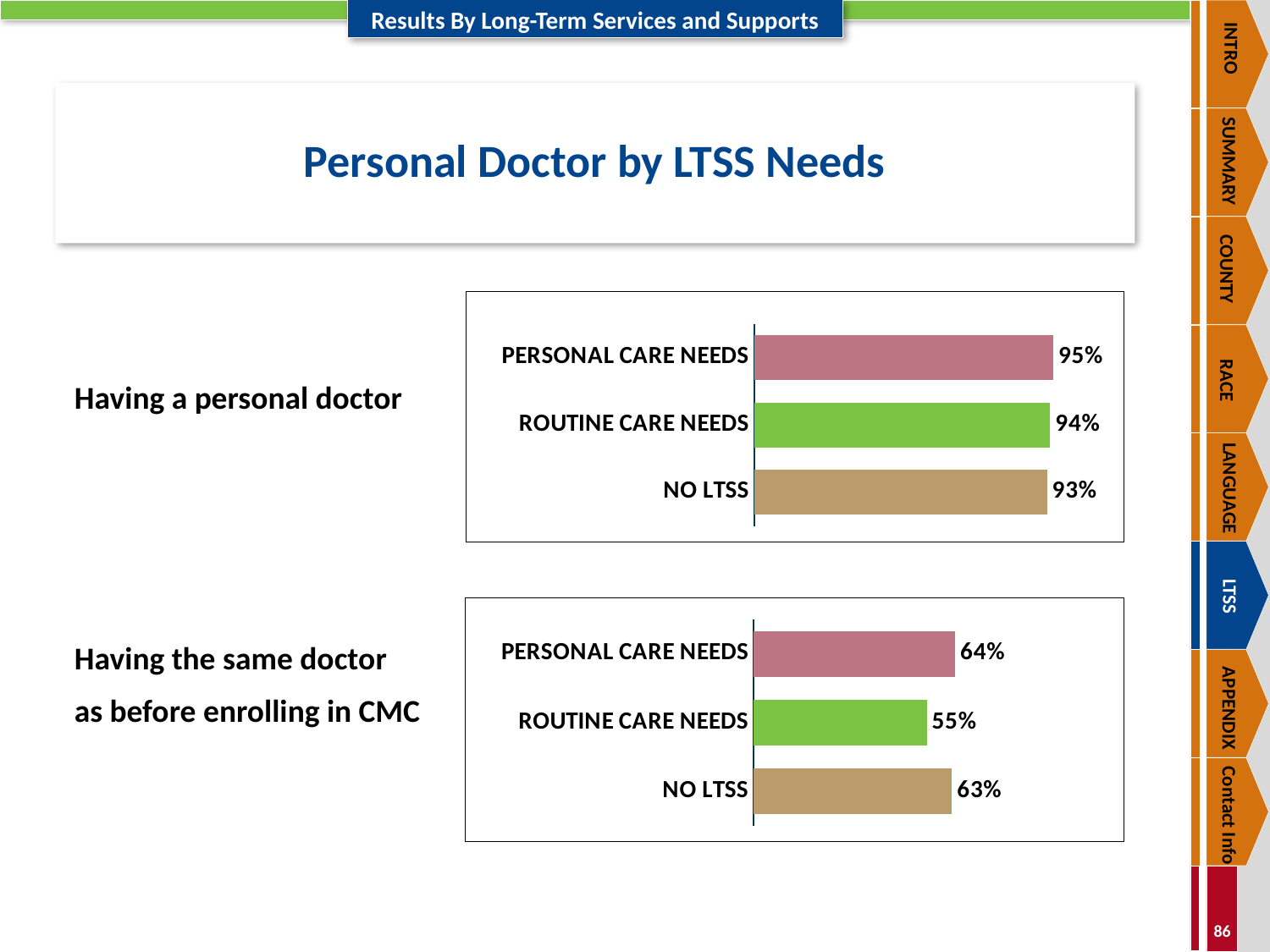
How many categories are shown in the 'Having a personal doctor' chart? 3 In the 'Having a personal doctor' chart, which category has the highest value? PERSONAL CARE NEEDS In the 'Having a personal doctor' chart, what is the value for PERSONAL CARE NEEDS? 95% What type of chart is the 'Having the same doctor as before enrolling in CMC' chart? Bar chart In the 'Having the same doctor as before enrolling in CMC' chart, what is the value for PERSONAL CARE NEEDS? 64% In the 'Having a personal doctor' chart, what is the value for NO LTSS? 93% In the 'Having the same doctor as before enrolling in CMC' chart, which category has the lowest value? ROUTINE CARE NEEDS In the 'Having the same doctor as before enrolling in CMC' chart, what is the value for ROUTINE CARE NEEDS? 55% In the 'Having the same doctor as before enrolling in CMC' chart, what is the difference between PERSONAL CARE NEEDS and ROUTINE CARE NEEDS? 9% What is the title of the slide's chart section? Personal Doctor by LTSS Needs In the 'Having the same doctor as before enrolling in CMC' chart, which is larger: NO LTSS or ROUTINE CARE NEEDS? NO LTSS In the 'Having a personal doctor' chart, what is the difference between PERSONAL CARE NEEDS and NO LTSS? 2%